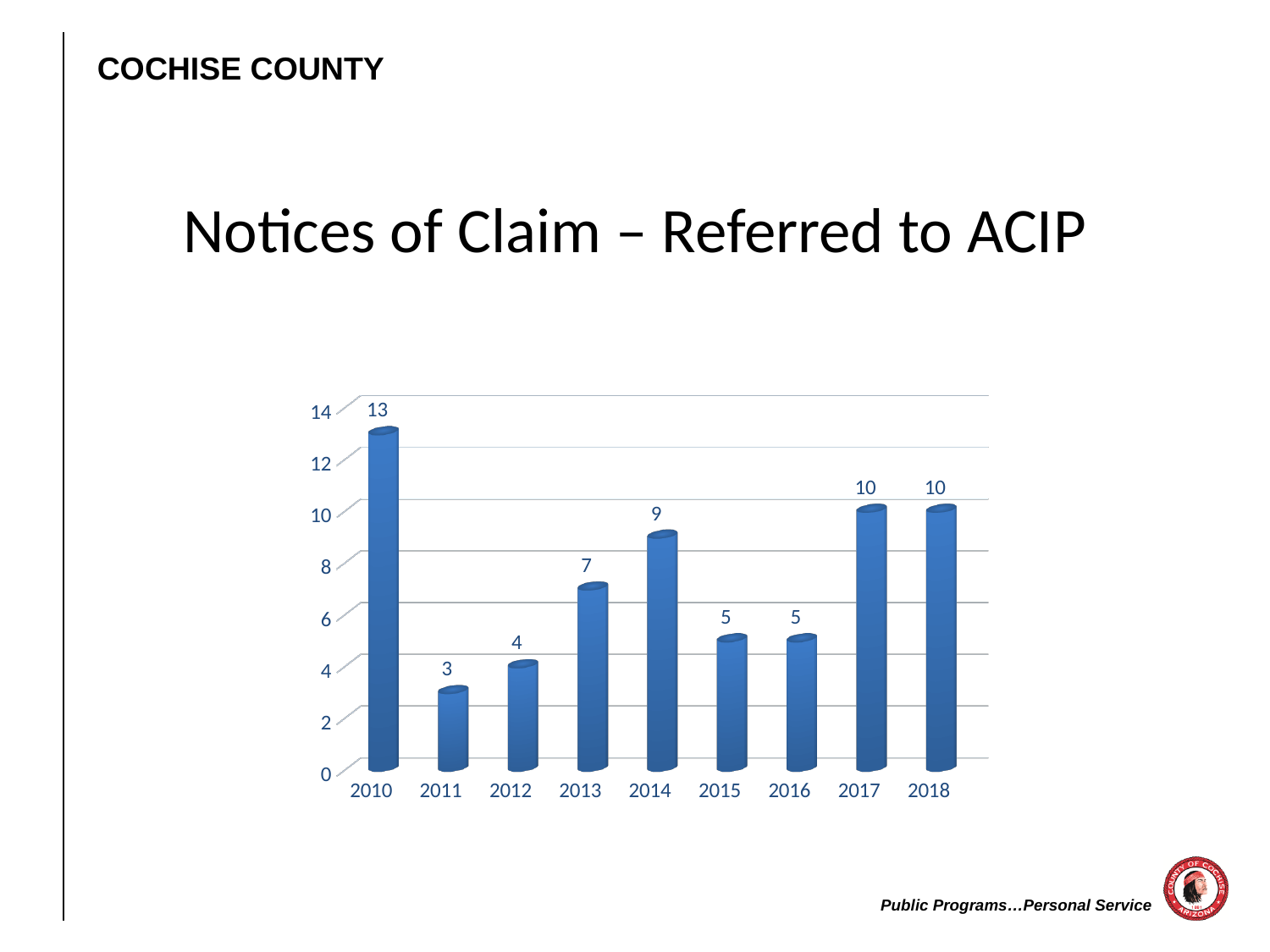
Which is larger, the value for 2013 or the value for 2012? 2013 What kind of chart is shown on the slide? bar chart How many years are shown on the x axis? 9 What is the value for 2014? 9 What is the difference between the values for 2017 and 2013? 3 What is the value for 2010? 13 Which year has the highest value? 2010 What is the value for 2016? 5 Which year has the lowest value? 2011 Is the value for 2014 greater or less than 8? greater What is the title of the chart? Notices of Claim – Referred to ACIP What is the difference between the values for 2010 and 2011? 10